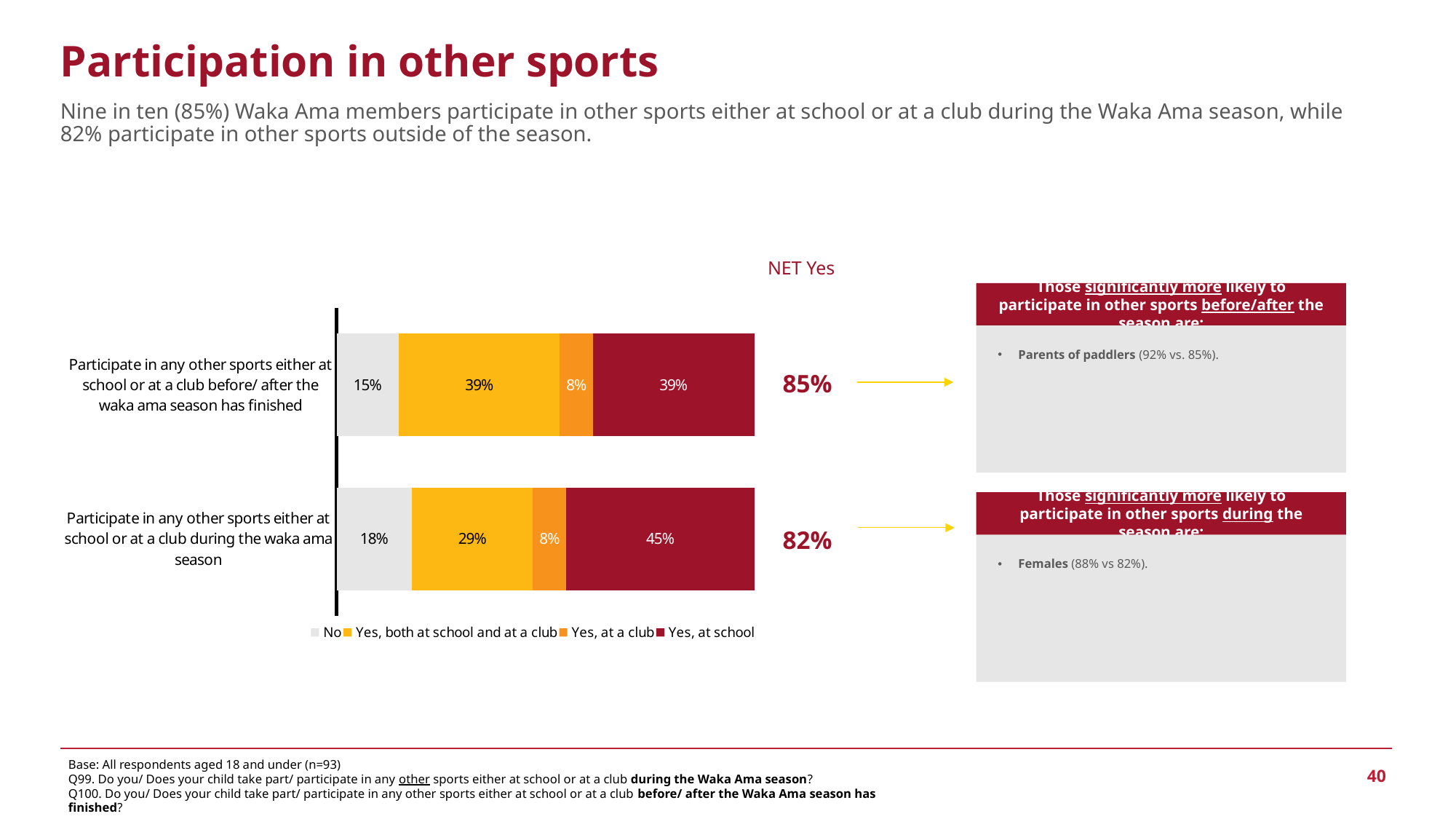
What NET Yes value is shown next to the bar for participating in other sports before/after the waka ama season has finished? 85% What type of chart is shown on the slide? Stacked bar chart Which segment is the largest in the bar for participating in other sports during the waka ama season? Yes, at school What percentage answered 'No' for participating in other sports during the waka ama season? 18% How many series does the chart legend list? 4 What percentage answered 'No' for participating in other sports before/after the waka ama season has finished? 15% Which bar has the larger 'Yes, both at school and at a club' value: before/after the season or during the season? Before/after the season What is the difference between the 'Yes, at school' values for the during-season bar and the before/after-season bar? 6% How many categories (bars) are plotted in the chart? 2 What is the 'Yes, at school' value for participating in other sports during the waka ama season? 45% Which legend entry is shown in grey? No What is the 'Yes, both at school and at a club' value for participating in other sports before/after the waka ama season has finished? 39%